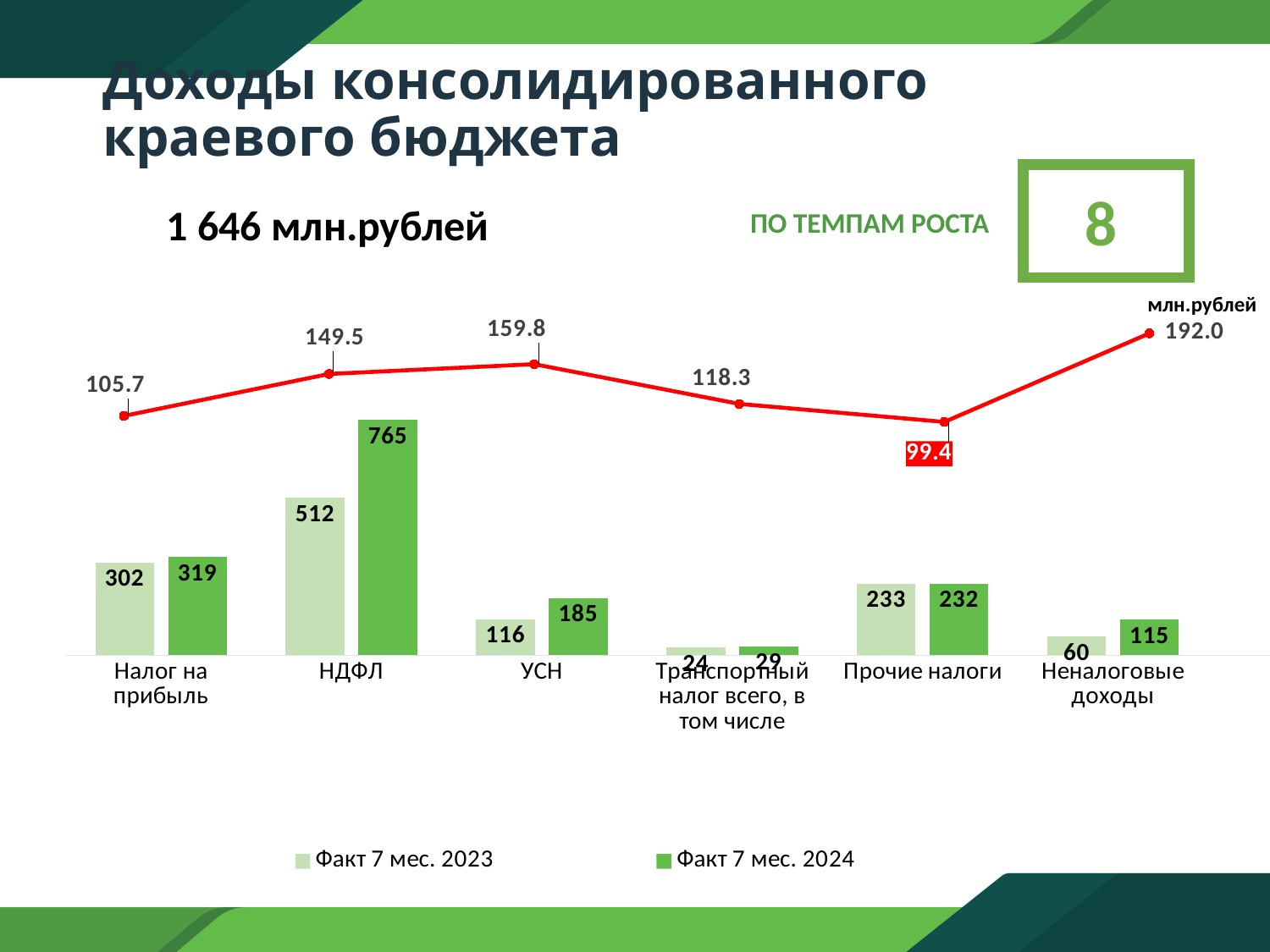
Which category has the lowest value on the red growth-rate line? Прочие налоги What is the growth rate value shown on the red line for УСН? 159.8 What is the value for Неналоговые доходы in the Факт 7 мес. 2023 series? 60 Which category has the highest value in the Факт 7 мес. 2024 series? НДФЛ How many series does the legend list? 2 What unit is indicated in the top right corner of the chart? млн.рублей How many categories are shown on the x axis of the chart? 6 What is the value for НДФЛ in the Факт 7 мес. 2024 series? 765 What is the difference between the Факт 7 мес. 2024 and Факт 7 мес. 2023 values for НДФЛ? 253 What kind of chart is shown on the slide? Combined bar and line chart Which category has the lowest value in the Факт 7 мес. 2023 series? Транспортный налог всего, в том числе Which is larger for Прочие налоги: the Факт 7 мес. 2023 value or the Факт 7 мес. 2024 value? Факт 7 мес. 2023